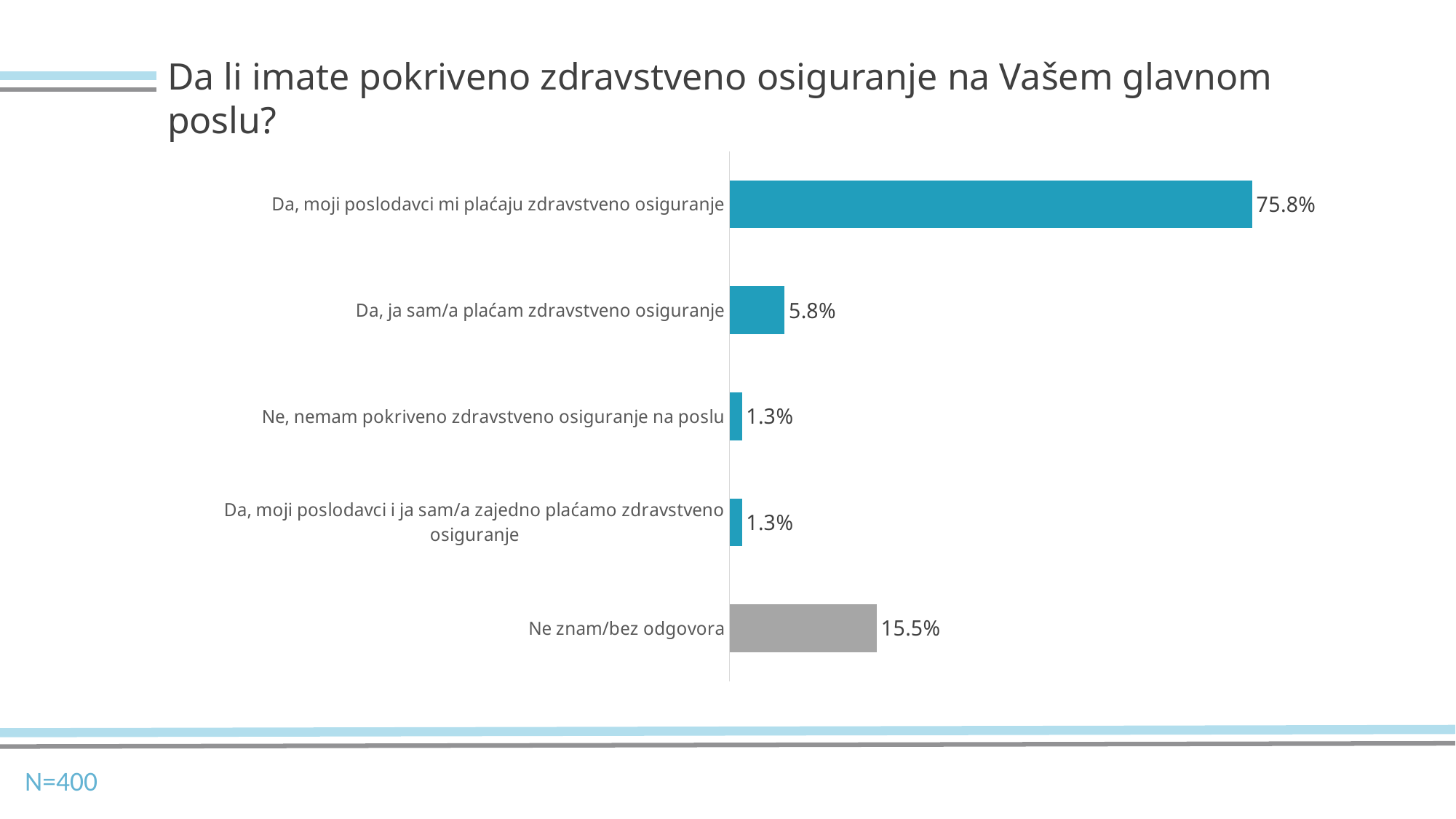
Which response category has the highest value? Da, moji poslodavci mi plaćaju zdravstveno osiguranje Which bar is coloured grey rather than blue? Ne znam/bez odgovora Which is larger: "Ne znam/bez odgovora" or "Da, ja sam/a plaćam zdravstveno osiguranje"? Ne znam/bez odgovora What is the sample size (N) stated on the slide? N=400 How many response categories are shown in the chart? 5 What is the difference between "Da, moji poslodavci mi plaćaju zdravstveno osiguranje" and "Ne znam/bez odgovora"? 60.3% What is the value for "Ne, nemam pokriveno zdravstveno osiguranje na poslu"? 1.3% What type of chart is shown on the slide? Bar chart What is the value for "Ne znam/bez odgovora"? 15.5% What is the difference between "Ne znam/bez odgovora" and "Da, ja sam/a plaćam zdravstveno osiguranje"? 9.7% What percentage of respondents answered "Da, moji poslodavci mi plaćaju zdravstveno osiguranje"? 75.8% What is the value for "Da, ja sam/a plaćam zdravstveno osiguranje"? 5.8%